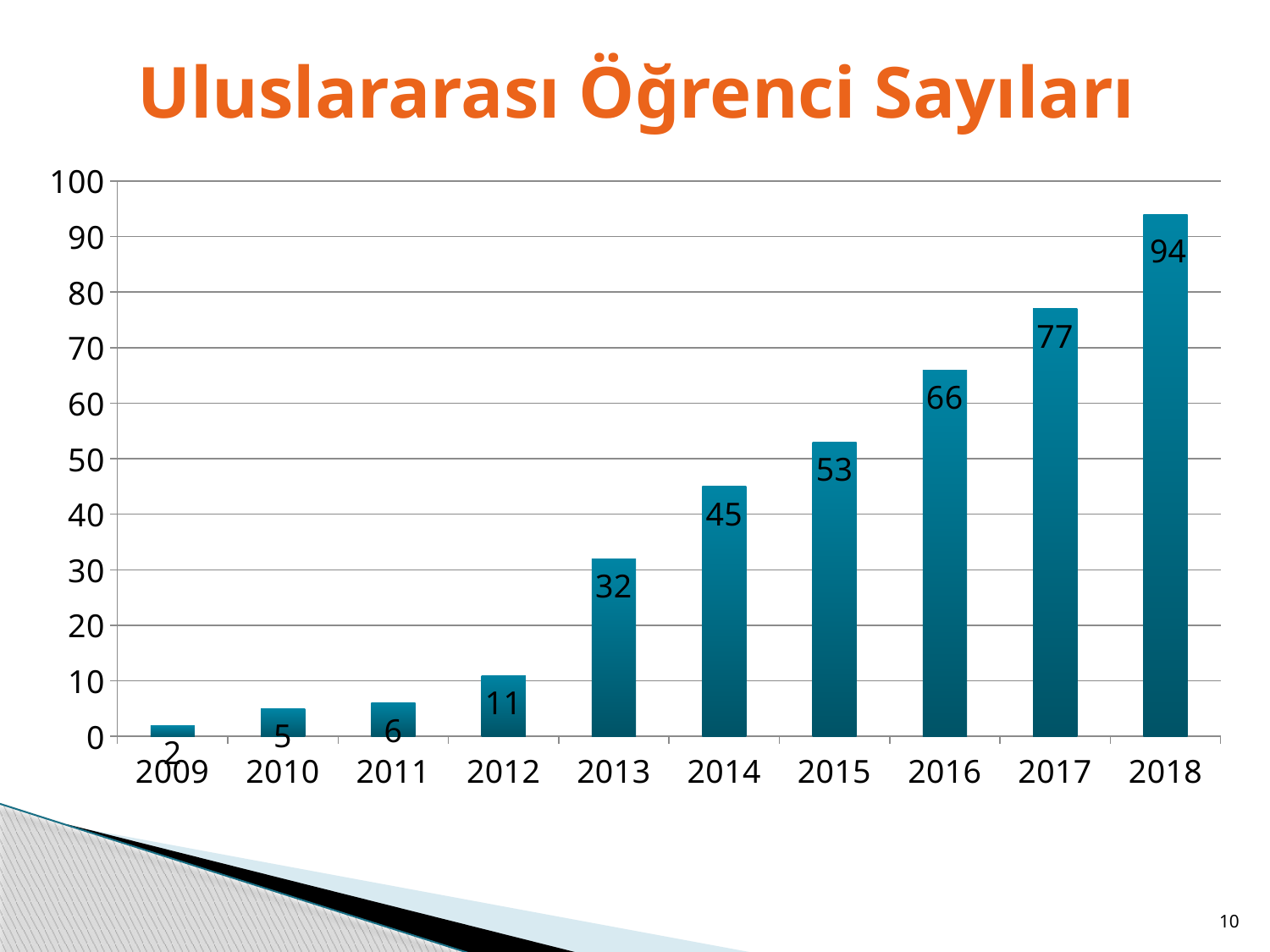
How many years are shown on the x axis? 10 What is the difference between the values for 2018 and 2017? 17 What is the value for 2013? 32 Is the value for 2017 greater or less than 70? greater What is the difference between the values for 2015 and 2014? 8 Do the values rise or fall from 2009 to 2018? rise What is the value for 2016? 66 Which year has the highest value? 2018 What is the value for 2009? 2 Which is larger, the value for 2012 or the value for 2011? 2012 Which year has the lowest value? 2009 What kind of chart is shown on the slide? bar chart